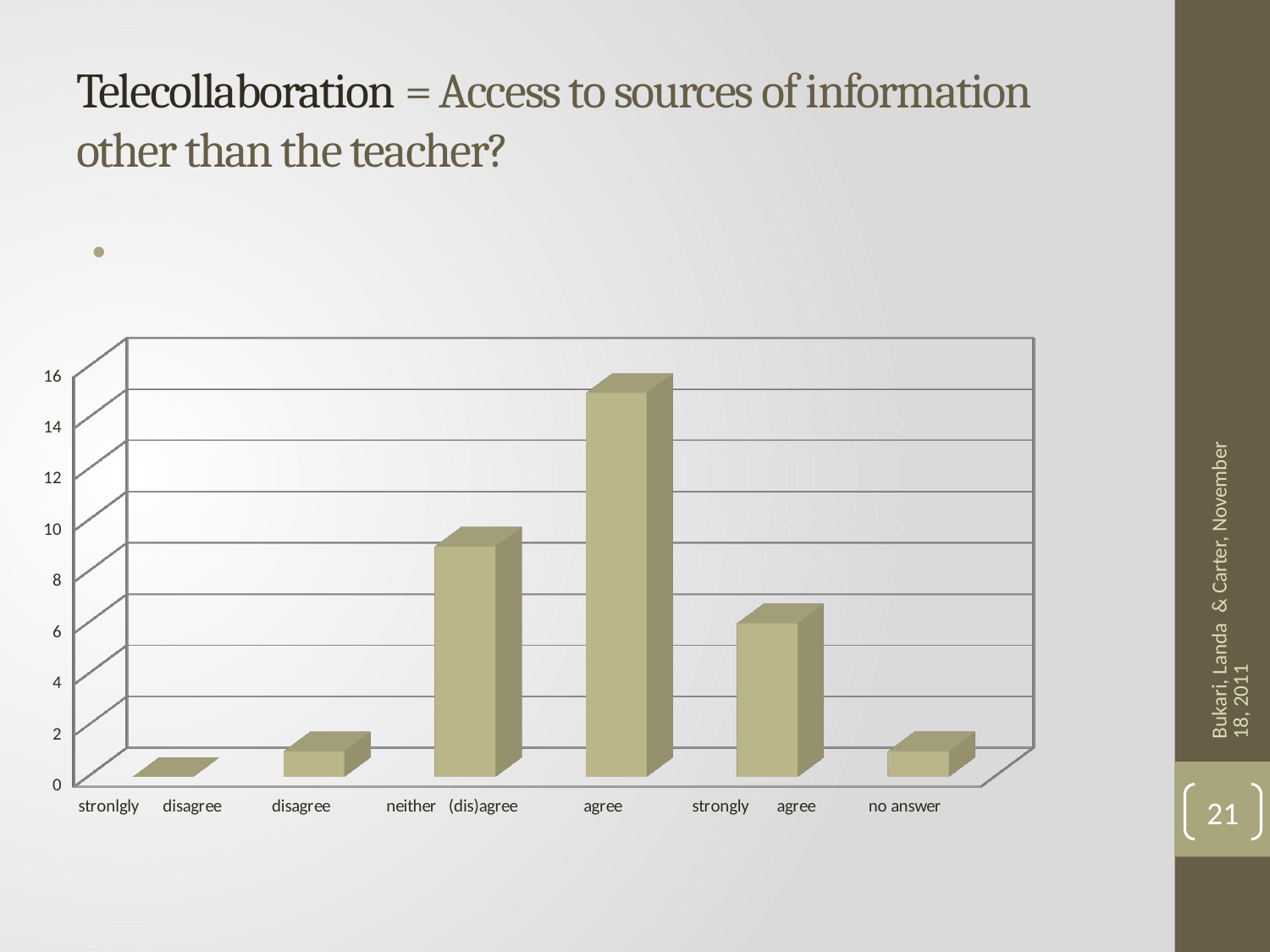
Which is larger, the value for strongly agree or the value for no answer? strongly agree Which category has the highest bar? agree Is the value for neither (dis)agree greater or less than 10? less How many categories are shown on the x axis of the chart? 6 Which category has the lowest bar? strongly disagree What is the value for strongly disagree? 0 Is the value for neither (dis)agree greater or less than 8? greater Is the value for disagree greater or less than 2? less Which is larger, the value for agree or the value for neither (dis)agree? agree What kind of chart is shown on the slide? bar chart